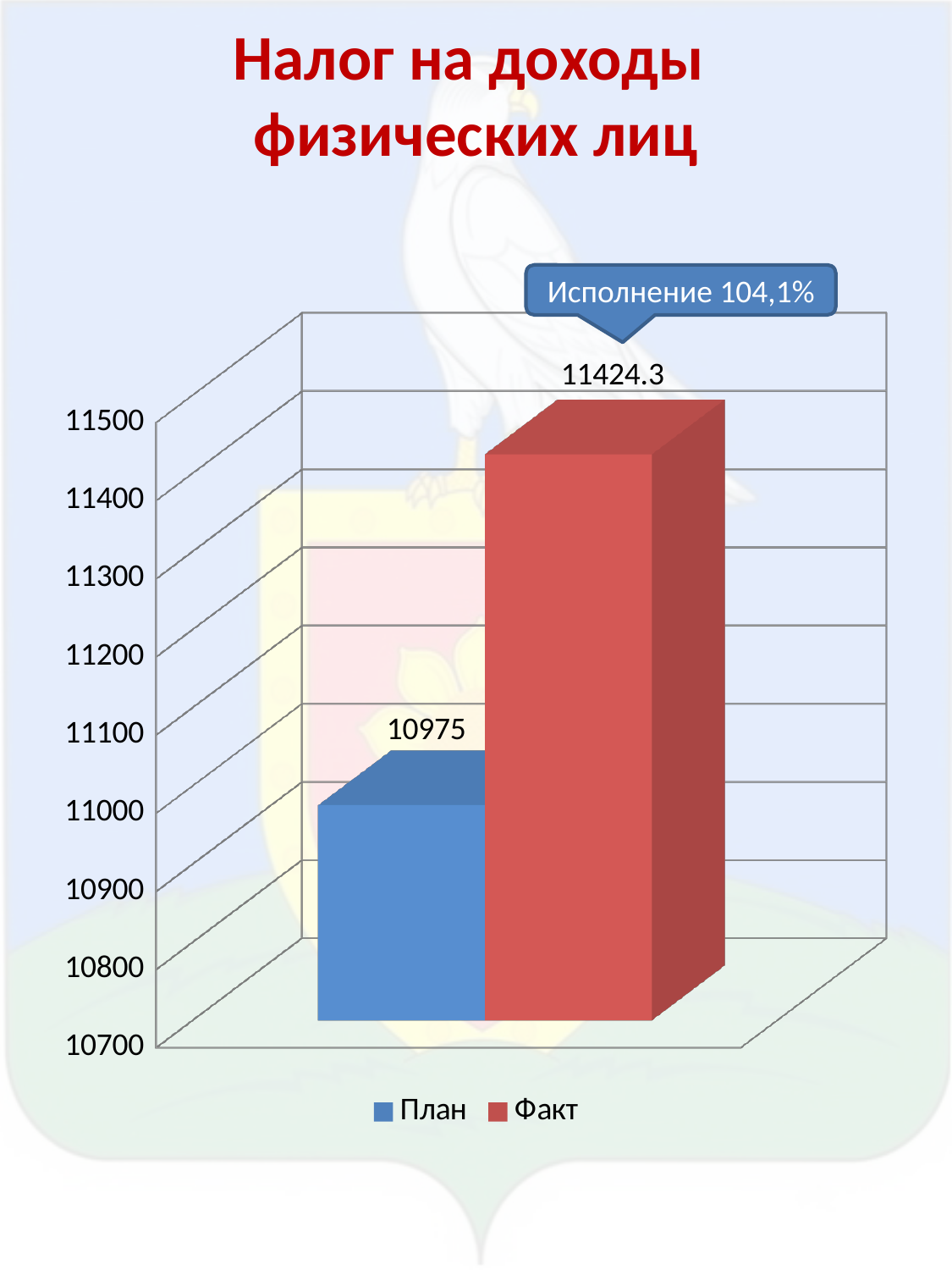
Which bar is higher, План or Факт? Факт How many bars are plotted on the chart? 2 Is the value for План greater or less than 11000? less What is the value of the Факт bar? 11424.3 What kind of chart is shown on the slide? Bar chart What execution percentage is shown in the callout above the chart? 104,1% What is the value of the План bar? 10975 Is the value for Факт greater or less than 11400? greater What is the difference between the Факт and План values? 449.3 What is the title of the slide? Налог на доходы физических лиц How many series does the legend list? 2 Which bar is lower, План or Факт? План